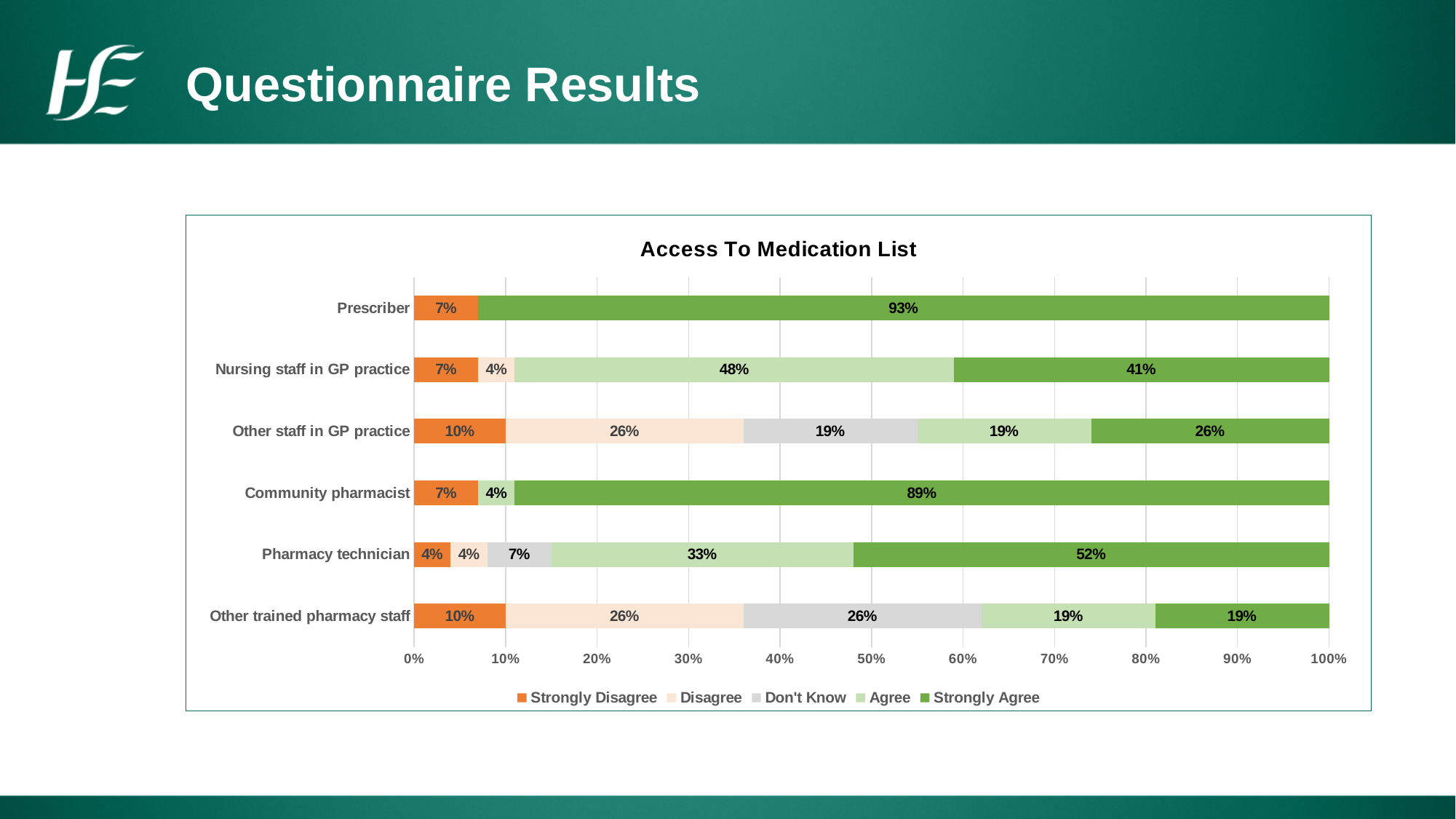
What is the Strongly Agree value for Pharmacy technician? 52% What type of chart is shown on the slide? Stacked bar chart What is the title of the chart? Access To Medication List How many categories (staff groups) are shown on the chart? 6 What is the difference between the Strongly Agree values for Community pharmacist and Nursing staff in GP practice? 48% How many series does the legend list? 5 What is the Agree value for Nursing staff in GP practice? 48% What is the Strongly Agree value for Prescriber? 93% What is the Don't Know value for Other trained pharmacy staff? 26% Which category has the highest Strongly Agree value? Prescriber Which is larger: the Strongly Disagree value for Other staff in GP practice or for Pharmacy technician? Other staff in GP practice Which category has the lowest Strongly Agree value? Other trained pharmacy staff